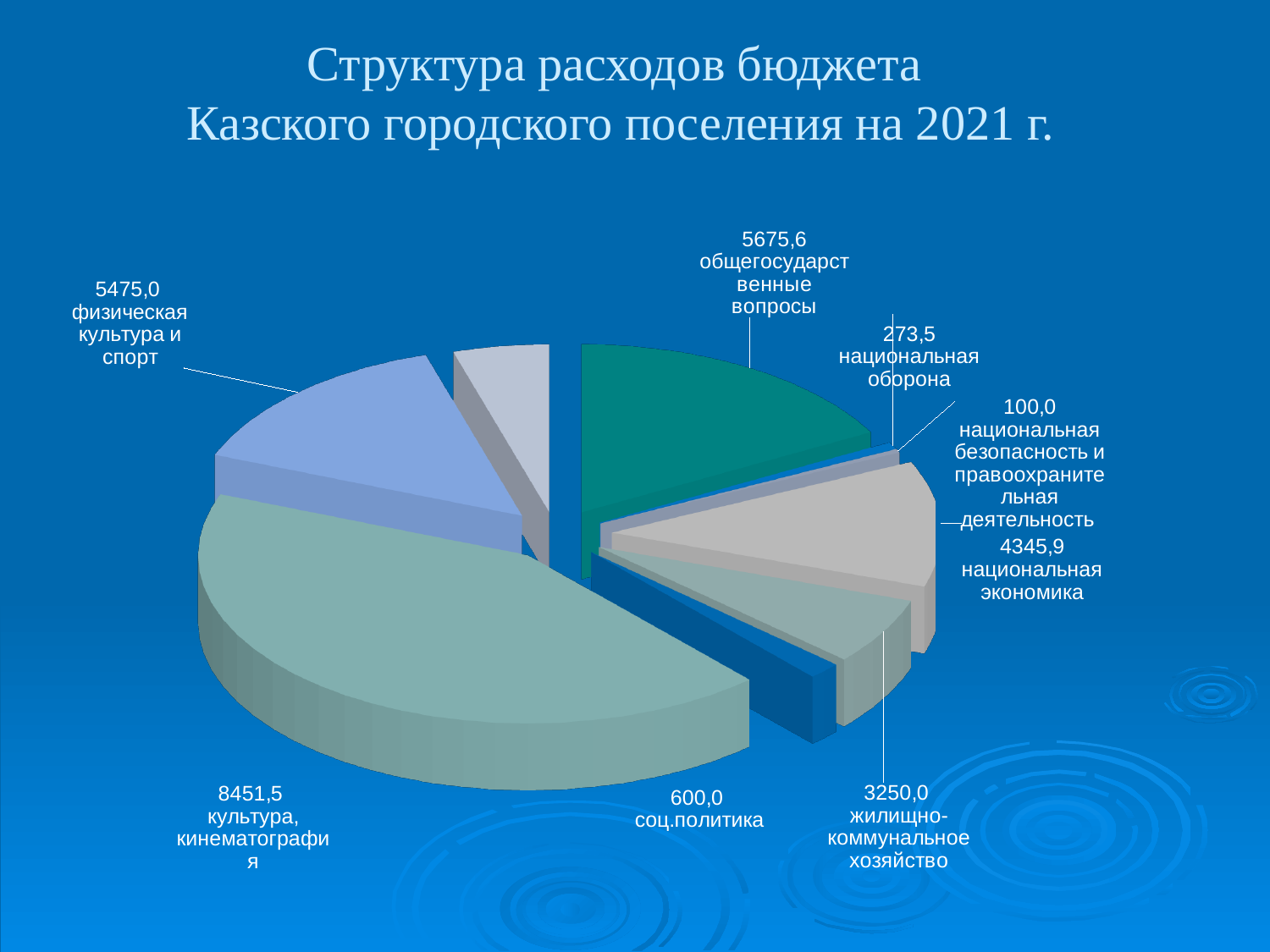
What is the value for культура, кинематография? 8451,5 Which is larger: общегосударственные вопросы or физическая культура и спорт? общегосударственные вопросы What kind of chart is shown on the slide? pie chart What is the title of the chart? Структура расходов бюджета Казского городского поселения на 2021 г. What is the difference between национальная экономика and жилищно-коммунальное хозяйство? 1095,9 Which labeled category has the smallest value? национальная безопасность и правоохранительная деятельность What is the difference between культура, кинематография and общегосударственные вопросы? 2775,9 What is the value for национальная оборона? 273,5 What is the value for общегосударственные вопросы? 5675,6 Which category has the largest value? культура, кинематография What is the value for национальная экономика? 4345,9 What is the value for жилищно-коммунальное хозяйство? 3250,0